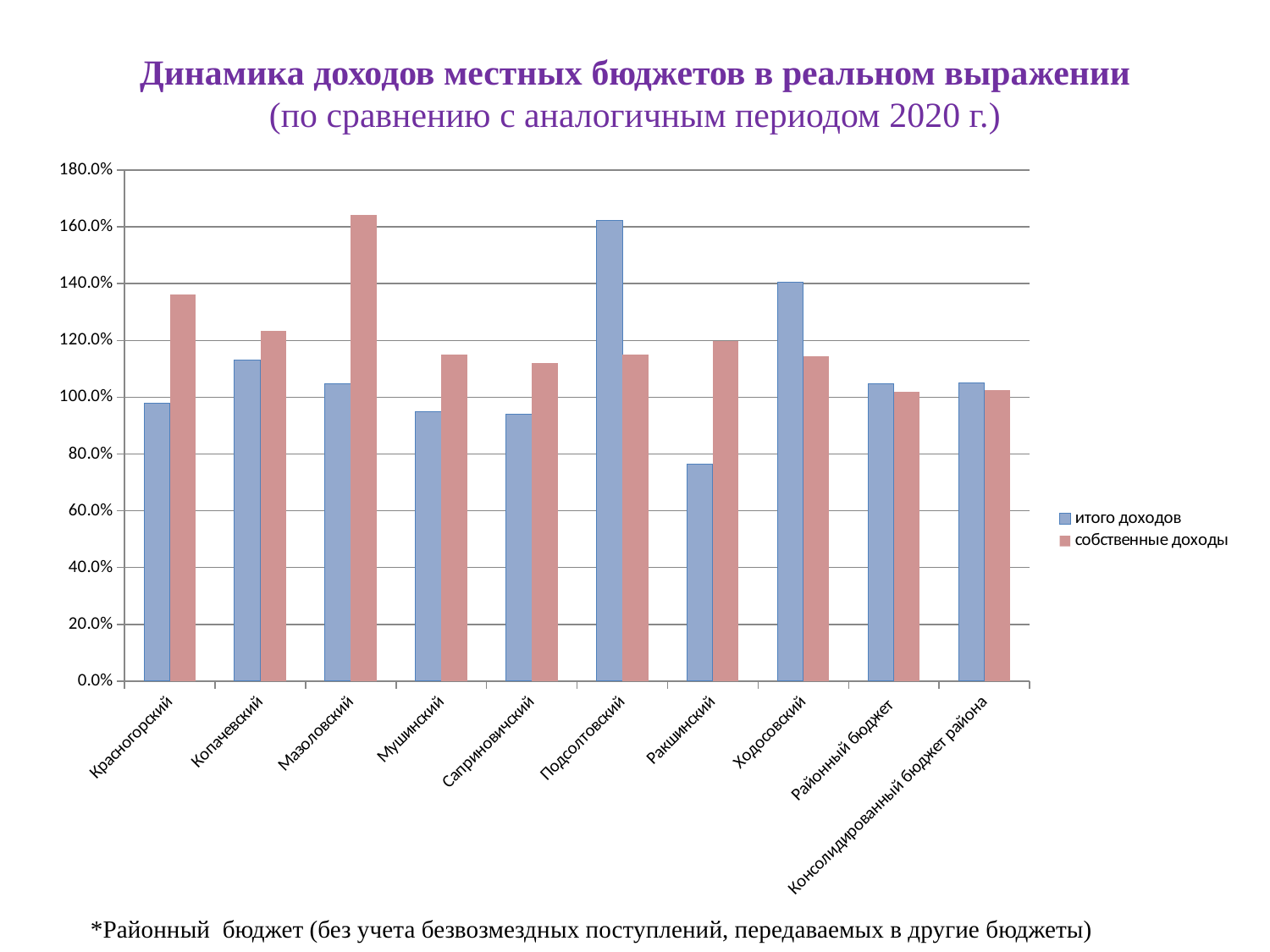
Is the value of итого доходов for Ракшинский greater or less than 80.0%? less Which category has the lowest value for итого доходов? Ракшинский For Ходосовский, which series has the larger value: итого доходов or собственные доходы? итого доходов How many series does the legend list? 2 What kind of chart is shown on the slide? bar chart Is the value of собственные доходы for Мазоловский greater or less than 160.0%? greater Which series is shown in blue in the legend? итого доходов Which category has the highest value for итого доходов? Подсолтовский Is the value of итого доходов for Красногорский greater or less than 100.0%? less Which category has the highest value for собственные доходы? Мазоловский For Красногорский, which series has the larger value: итого доходов or собственные доходы? собственные доходы How many categories are shown on the x axis? 10